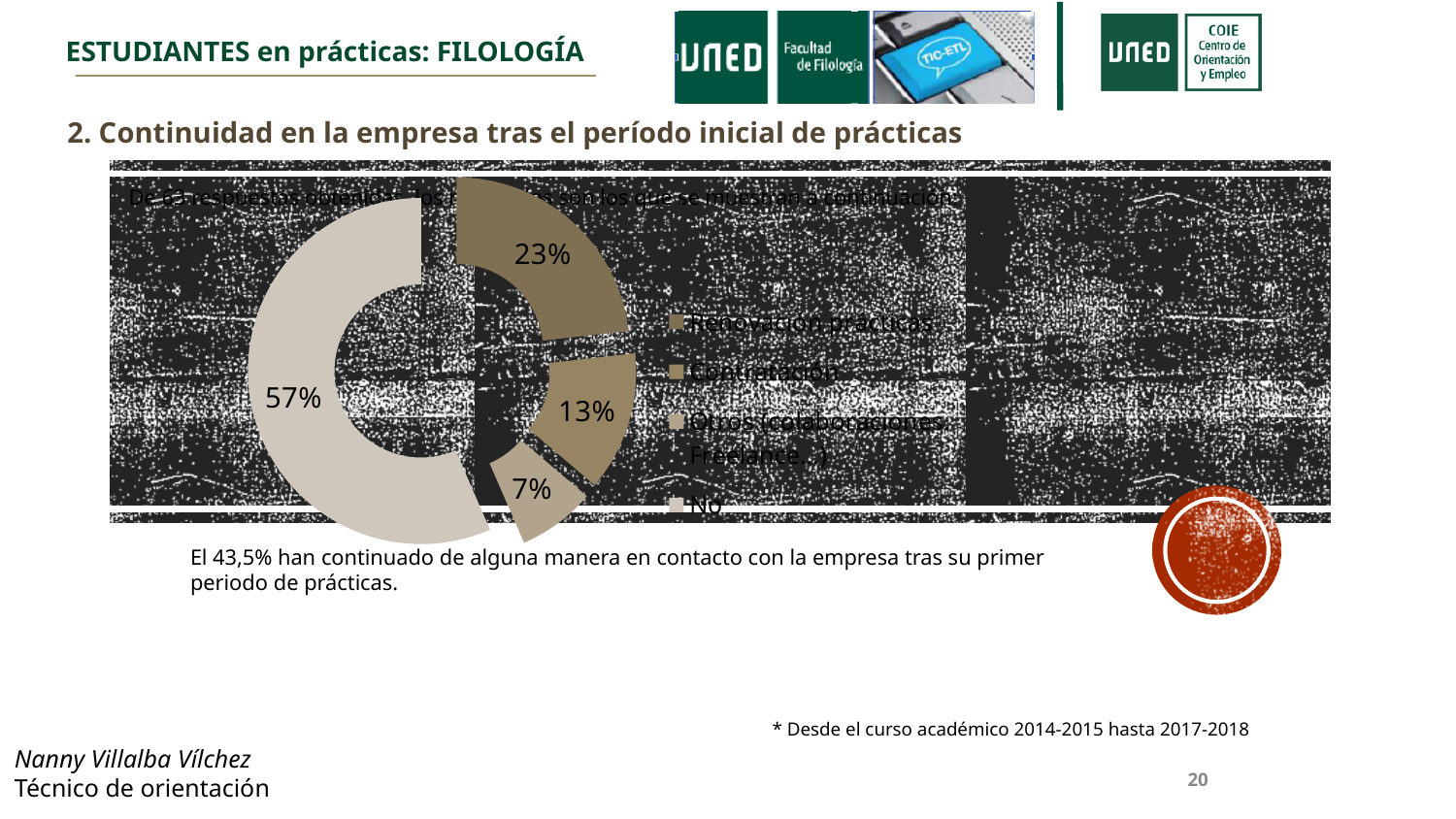
What percentage is shown for 'Otros (colaboraciones, Freelance...)' in the doughnut chart? 7% What is the combined percentage of 'Renovación prácticas' and 'Contratación' in the doughnut chart? 36% How many categories does the doughnut chart's legend list? 4 Which legend entry is listed first in the doughnut chart's legend? Renovación prácticas What percentage is shown for 'Contratación' in the doughnut chart? 13% What kind of chart is shown on the slide? doughnut chart Which category has the smallest share in the doughnut chart? Otros (colaboraciones, Freelance...) What percentage is shown for 'Renovación prácticas' in the doughnut chart? 23% What is the difference in percentage points between the 'No' slice and the 'Renovación prácticas' slice? 34 Which is larger in the doughnut chart, 'Contratación' or 'Otros (colaboraciones, Freelance...)'? Contratación Which category has the largest share in the doughnut chart? No What percentage is shown for the 'No' slice of the doughnut chart? 57%